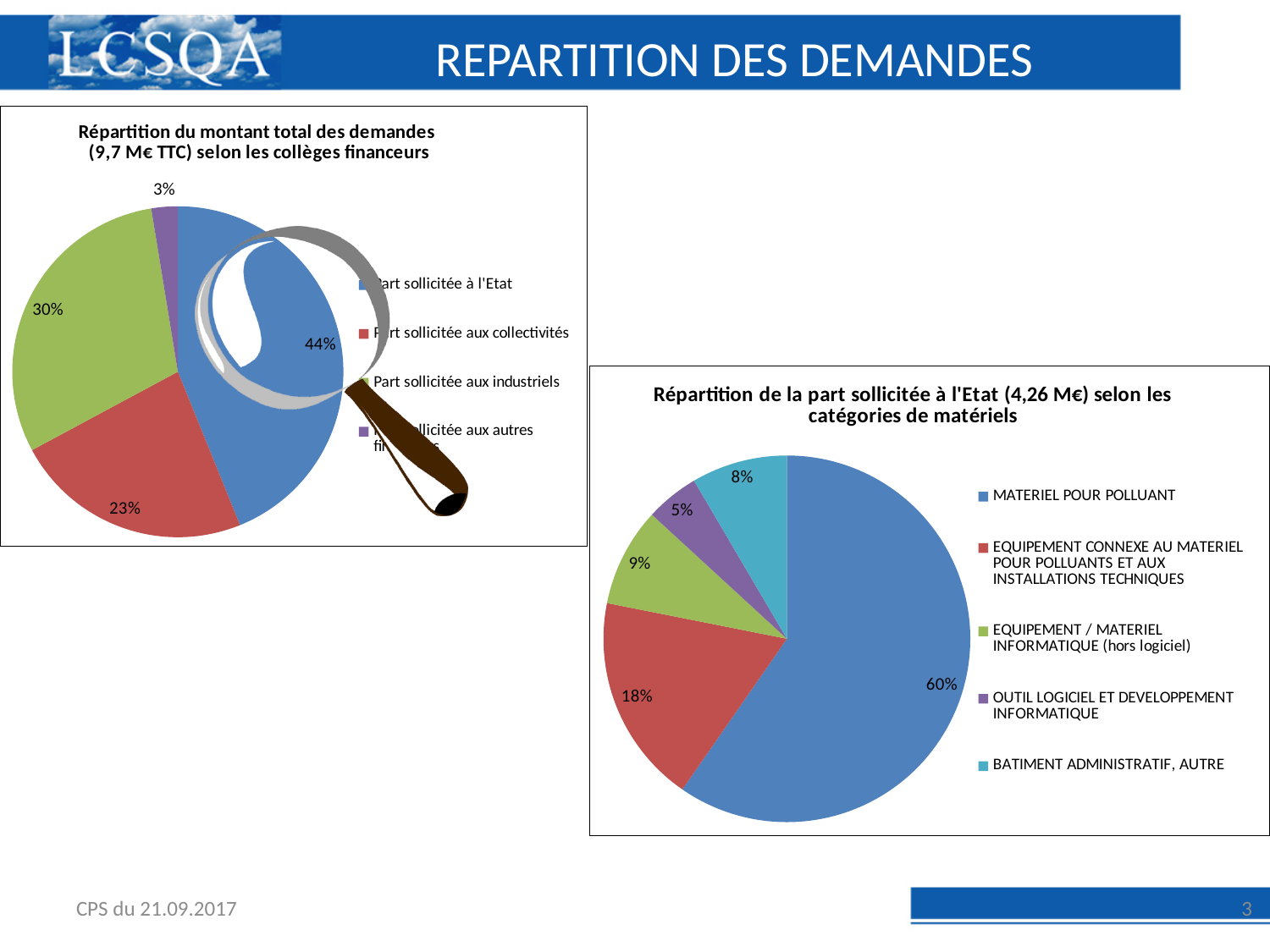
In the right-hand chart (Répartition de la part sollicitée à l'Etat), which category has the smallest share? OUTIL LOGICIEL ET DEVELOPPEMENT INFORMATIQUE In the left-hand chart (Répartition du montant total des demandes), what is the smallest slice's share? 3% In the left-hand chart (Répartition du montant total des demandes), which is larger: the 30% slice or the 23% slice? The 30% slice In the right-hand chart (Répartition de la part sollicitée à l'Etat), what share does OUTIL LOGICIEL ET DEVELOPPEMENT INFORMATIQUE have? 5% In the right-hand chart (Répartition de la part sollicitée à l'Etat), which category has the largest share? MATERIEL POUR POLLUANT In the right-hand chart (Répartition de la part sollicitée à l'Etat), what share does MATERIEL POUR POLLUANT have? 60% In the right-hand chart (Répartition de la part sollicitée à l'Etat), how many categories does the legend list? 5 In the left-hand chart (Répartition du montant total des demandes), what is the largest slice's share? 44% In the right-hand chart (Répartition de la part sollicitée à l'Etat), what share does BATIMENT ADMINISTRATIF, AUTRE have? 8% What kind of chart is the right-hand chart (Répartition de la part sollicitée à l'Etat)? Pie chart In the right-hand chart, which colour represents BATIMENT ADMINISTRATIF, AUTRE? Light blue (cyan) In the right-hand chart (Répartition de la part sollicitée à l'Etat), what is the difference in percentage points between MATERIEL POUR POLLUANT and EQUIPEMENT CONNEXE AU MATERIEL POUR POLLUANTS ET AUX INSTALLATIONS TECHNIQUES? 42 percentage points